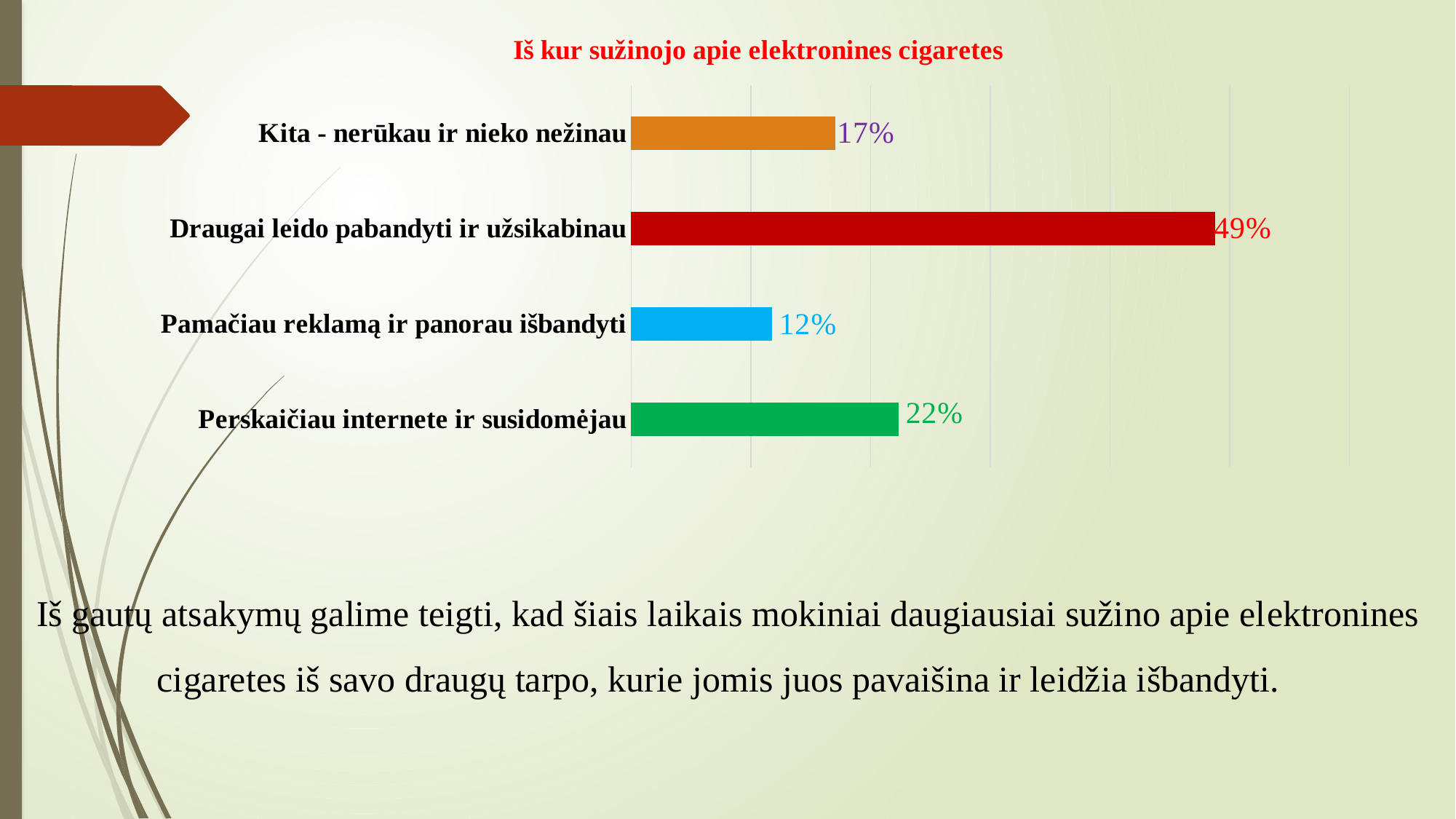
What is the difference between the values for "Kita - nerūkau ir nieko nežinau" and "Pamačiau reklamą ir panorau išbandyti"? 5% What is the value for "Pamačiau reklamą ir panorau išbandyti"? 12% What is the difference between the values for "Draugai leido pabandyti ir užsikabinau" and "Perskaičiau internete ir susidomėjau"? 27% Which is larger: the value for "Perskaičiau internete ir susidomėjau" or "Kita - nerūkau ir nieko nežinau"? Perskaičiau internete ir susidomėjau What is the title of the chart? Iš kur sužinojo apie elektronines cigaretes Which category has the highest value? Draugai leido pabandyti ir užsikabinau How many categories are shown in the chart? 4 What is the value for "Kita - nerūkau ir nieko nežinau"? 17% What is the value for "Perskaičiau internete ir susidomėjau"? 22% What is the value for "Draugai leido pabandyti ir užsikabinau"? 49% Which category has the lowest value? Pamačiau reklamą ir panorau išbandyti What kind of chart is shown on the slide? Bar chart